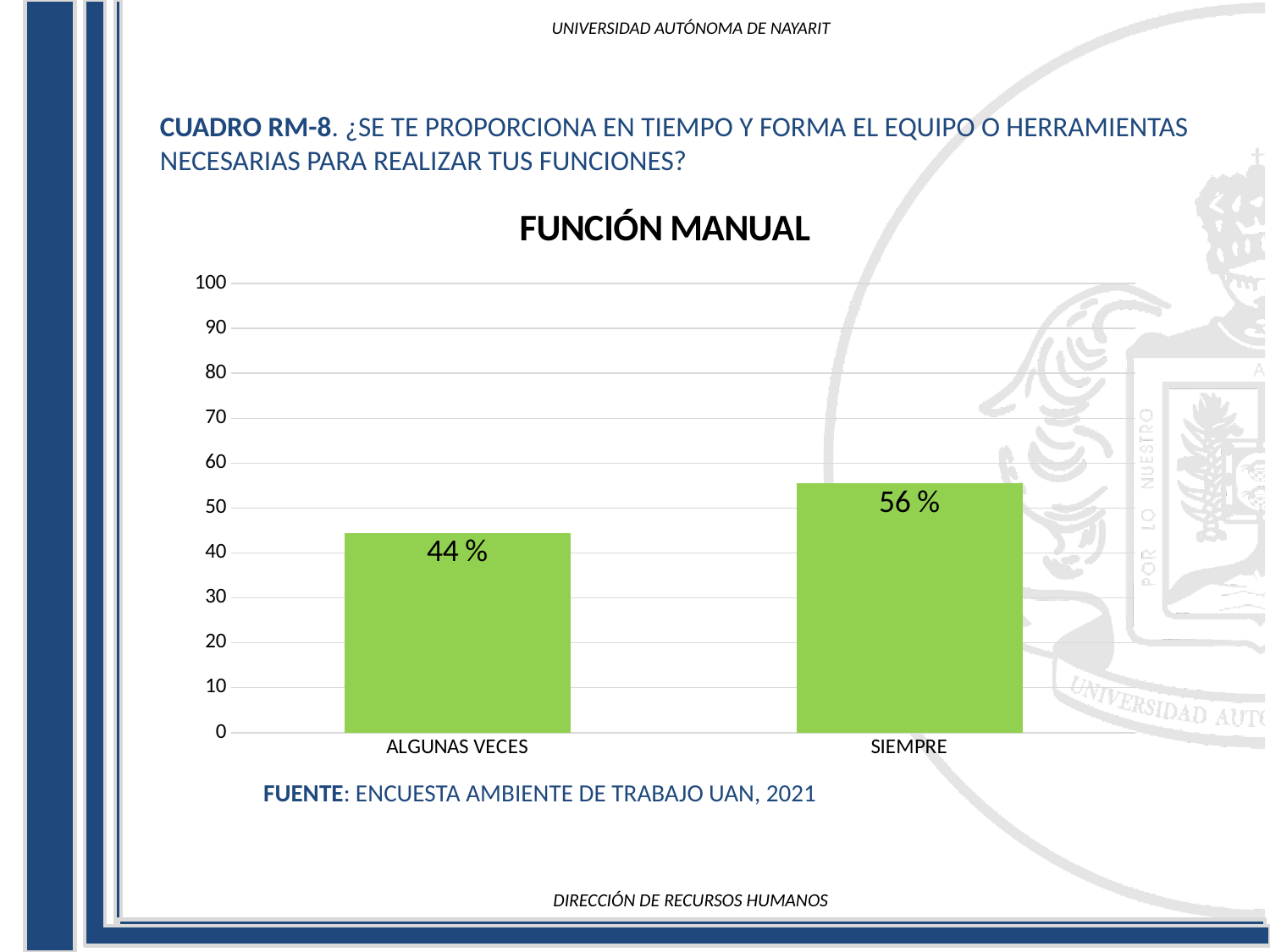
What is the difference between the values for SIEMPRE and ALGUNAS VECES? 12 % What is the title of the chart? FUNCIÓN MANUAL What is the value for ALGUNAS VECES? 44 % What kind of chart is shown on the slide? bar chart Which is larger, the value for ALGUNAS VECES or the value for SIEMPRE? SIEMPRE How many categories are shown on the x axis? 2 What is the value for SIEMPRE? 56 % Is the value for SIEMPRE greater or less than 50? greater Is the value for ALGUNAS VECES greater or less than 50? less Which category has the highest value? SIEMPRE What is the maximum value shown on the y axis? 100 Which category has the lowest value? ALGUNAS VECES